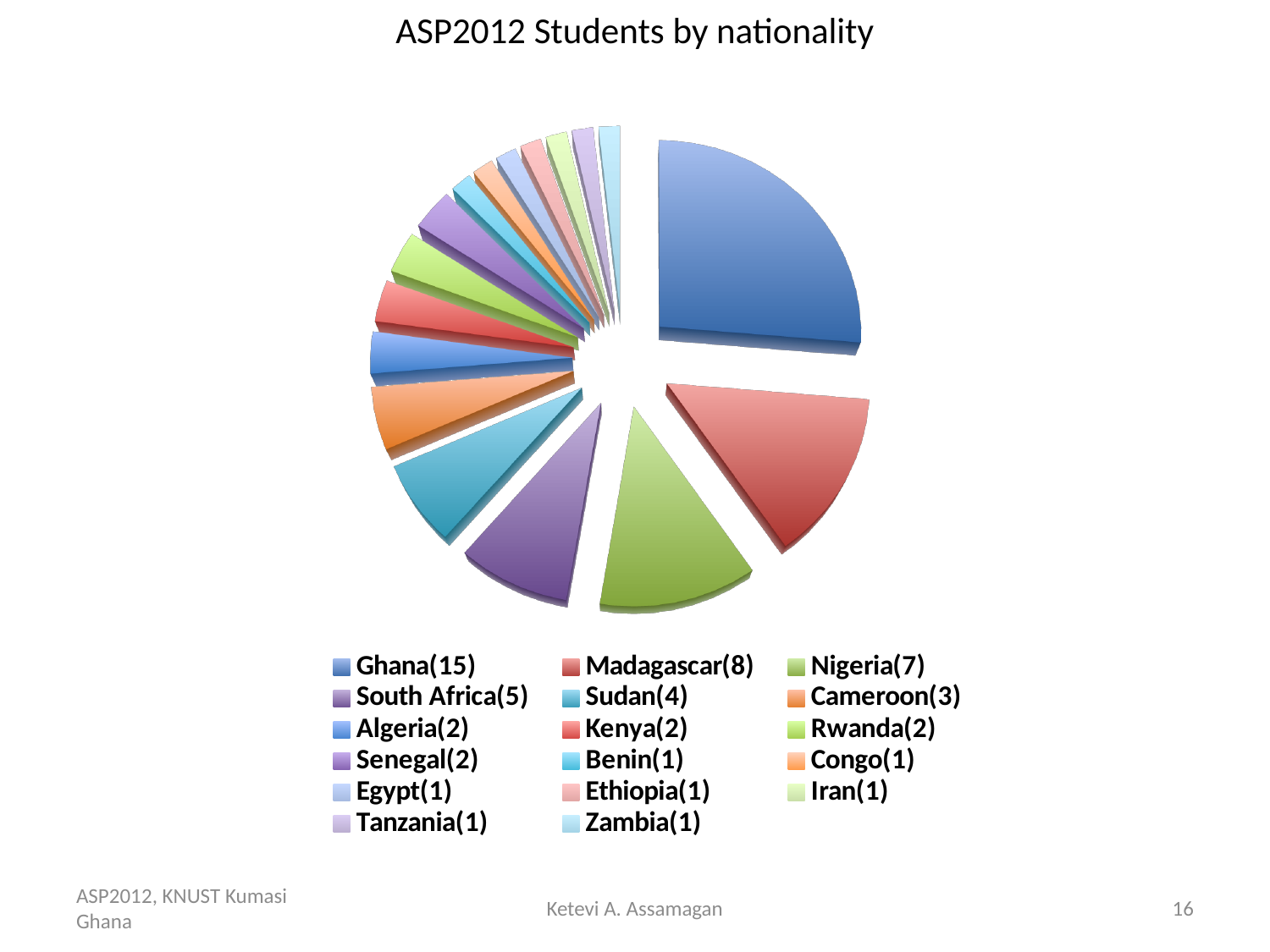
What is the total number of students across all nationalities shown? 57 What is the title of the chart? ASP2012 Students by nationality How many students are from Ghana? 15 What is the difference between the number of students from Ghana and from Nigeria? 8 What kind of chart is shown on the slide? Pie chart How many students are from South Africa? 5 How many nationalities are listed in the legend? 17 Which nationality has the largest number of students? Ghana Which has more students, Sudan or Madagascar? Madagascar How many nationalities have exactly 1 student? 7 How many students are from Cameroon? 3 How many students are from Madagascar? 8